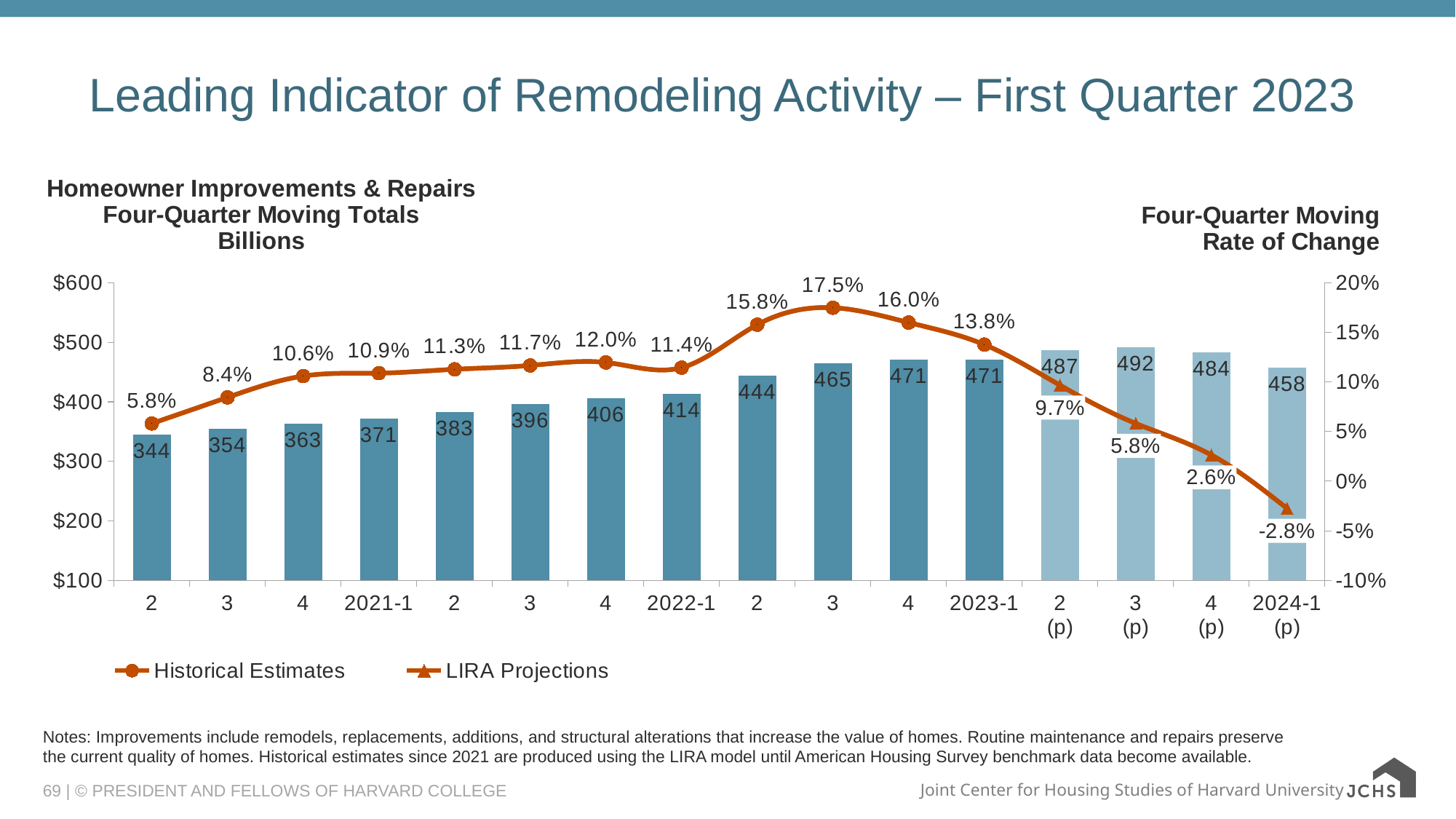
Which period has the highest four-quarter moving rate of change? 2022-3 (17.5%) Which is larger, the four-quarter moving total for 2021-1 or for 2022-1? 2022-1 What is the projected four-quarter moving total for 2024-1 (p)? 458 Which period has the highest four-quarter moving total bar? 2023-3 (p) (492) What is the projected rate of change for 2024-1 (p)? -2.8% How many series does the legend list? 2 What is the four-quarter moving total (in billions) for 2023-1? 471 How many bars (periods) are plotted on the chart? 16 What is the difference between the four-quarter moving totals for 2023-1 and 2022-1? 57 What kind of chart is shown on the slide? Combined bar and line chart What is the four-quarter moving rate of change for 2022-1? 11.4% Does the rate of change line rise or fall from 2023-1 to 2024-1 (p)? Fall